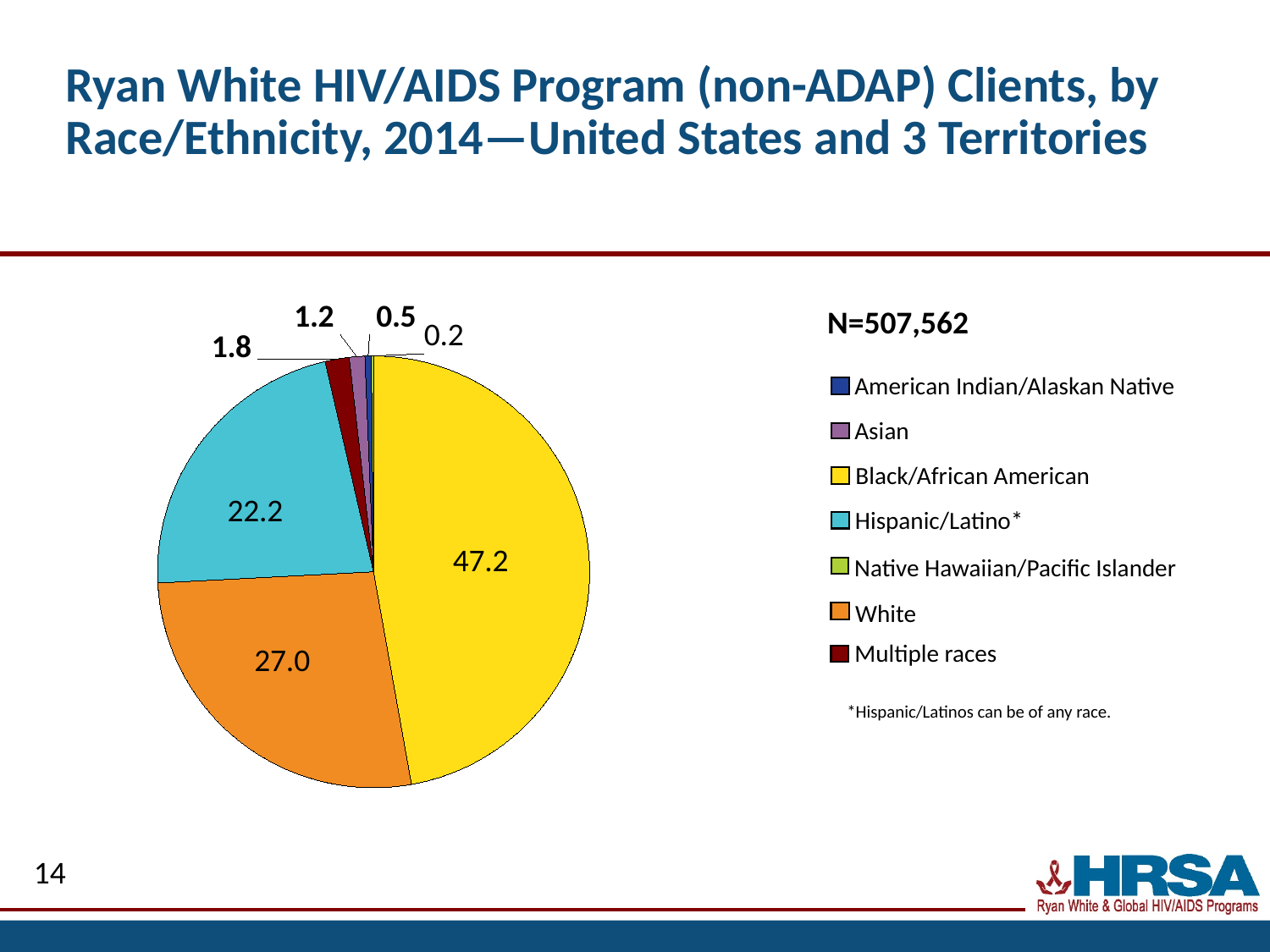
What colour represents the Hispanic/Latino category in the pie chart? Cyan (light blue) What value is shown for the Hispanic/Latino slice? 22.2 What type of chart is shown on the slide? Pie chart What is the difference between the Black/African American and White values? 20.2 Which race/ethnicity category has the smallest share of clients? Native Hawaiian/Pacific Islander What is the total number of clients (N) shown on the slide? N=507,562 What value is shown for the White slice? 27.0 What value is shown for the Multiple races slice? 1.8 Which is larger, the White slice or the Hispanic/Latino slice? White Which race/ethnicity category has the largest share of clients? Black/African American What percentage of clients are Black/African American? 47.2 How many race/ethnicity categories does the legend list? 7